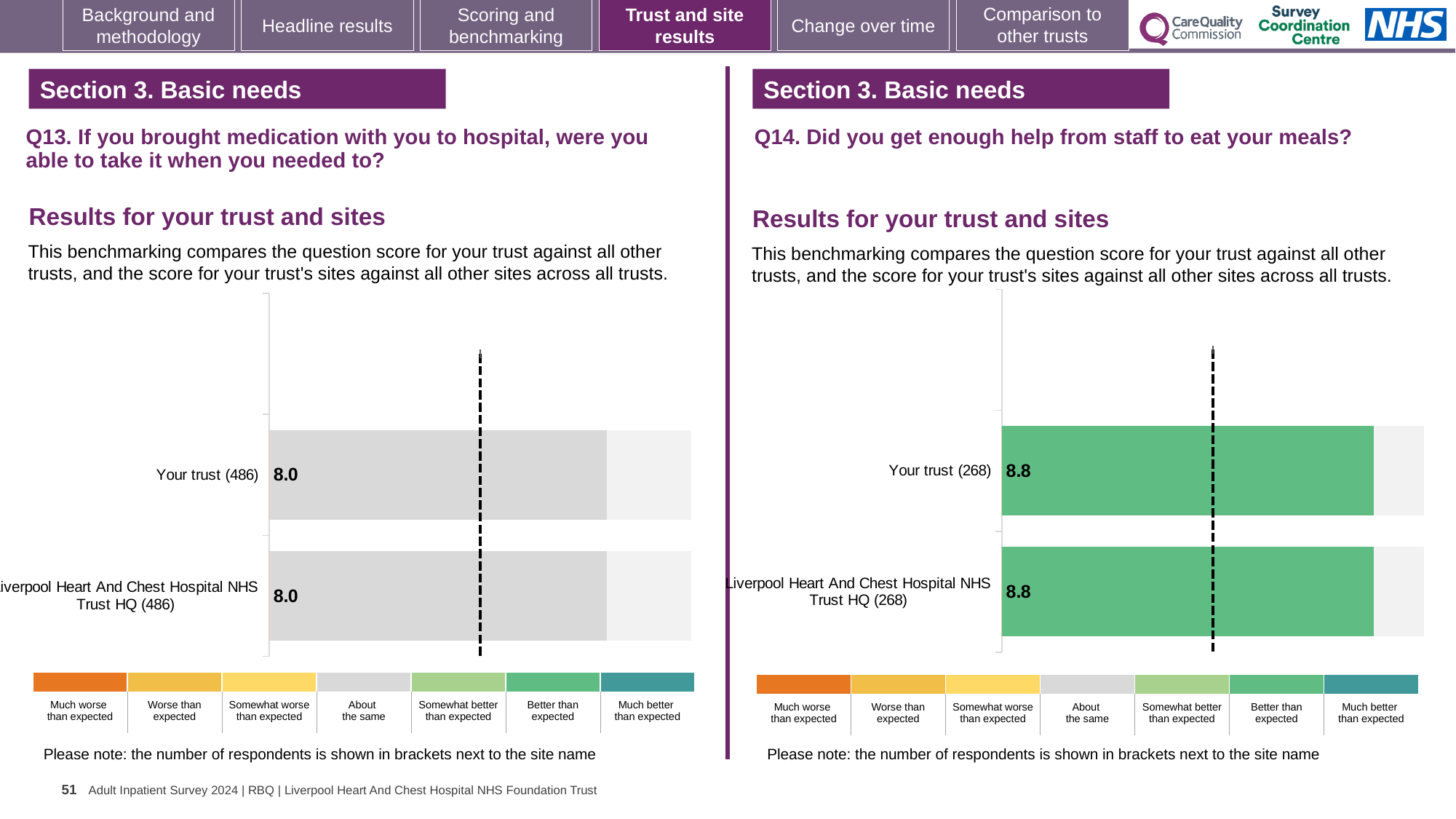
On the Q13 chart (left), what is the score for Liverpool Heart And Chest Hospital NHS Trust HQ? 8.0 On the Q14 chart (right), which benchmark category does the green colour of the bars correspond to in the legend? Better than expected On the Q14 chart (right), how many respondents are shown in brackets next to Your trust? 268 On the Q14 chart (right), what is the score for Liverpool Heart And Chest Hospital NHS Trust HQ? 8.8 On the Q13 chart (left), what is the difference between the score for Your trust and the score for Liverpool Heart And Chest Hospital NHS Trust HQ? 0.0 On the Q14 chart (right), what is the score for Your trust? 8.8 On the Q13 chart (left), how many respondents are shown in brackets next to Your trust? 486 On the Q13 chart (left), which benchmark category does the grey colour of the bars correspond to in the legend? About the same On the Q13 chart (left), what is the score for Your trust? 8.0 On the Q13 chart (left), how many bars are plotted? 2 What kind of chart is used on the Q13 chart (left)? Bar chart On the Q14 chart (right), how many bars are plotted? 2